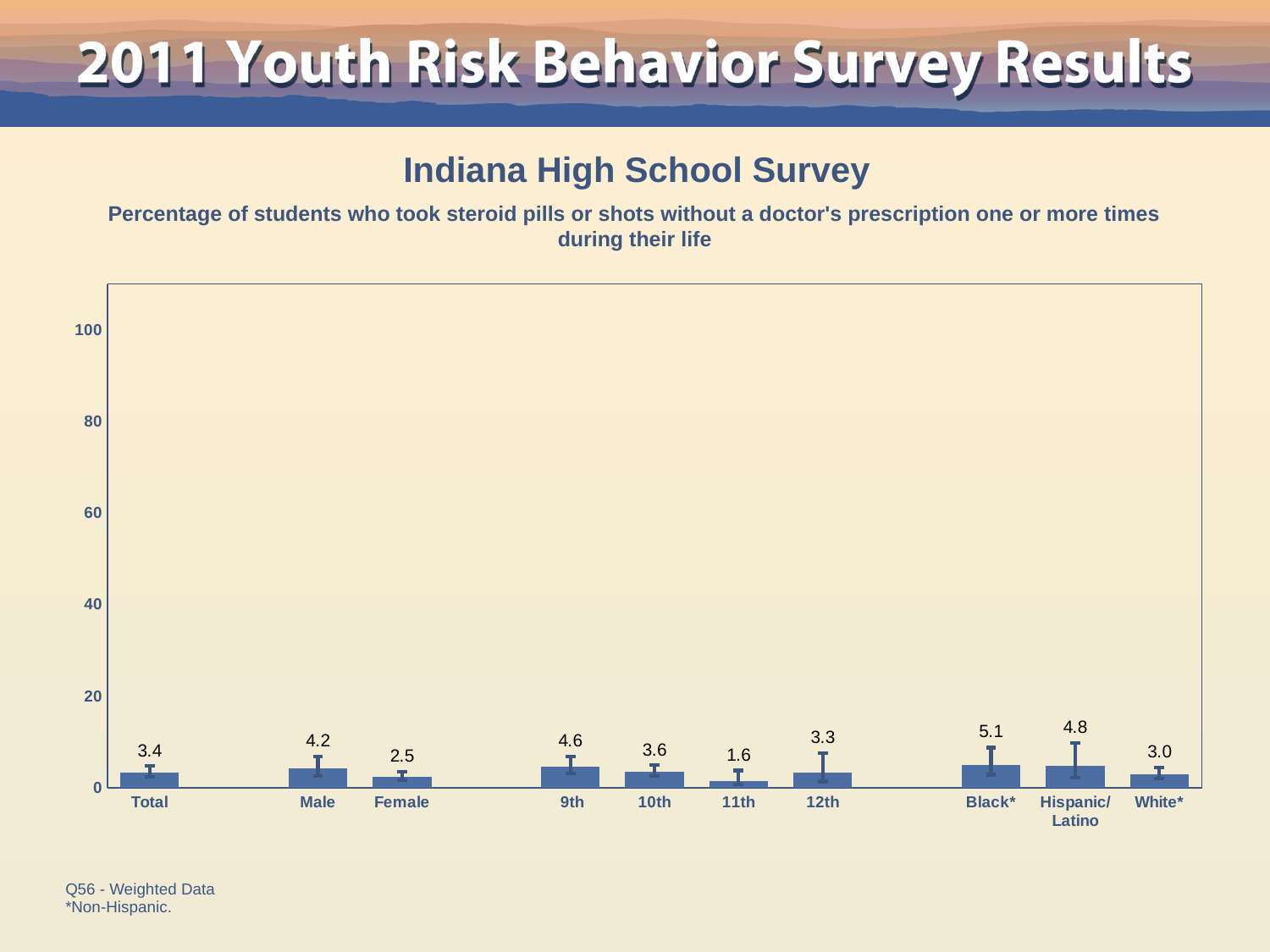
What is the value for Female? 2.5 What is the difference between the Male and Female values? 1.7 Which is larger, the value for 9th or the value for 12th? 9th Is the value for Black* greater or less than 20? less What is the value for Hispanic/Latino? 4.8 What is the title of the chart? Indiana High School Survey What is the value for 11th grade? 1.6 What is the value for Total? 3.4 What kind of chart is shown on the slide? bar chart Which category has the highest value? Black* How many categories are shown on the x axis? 10 Which category has the lowest value? 11th